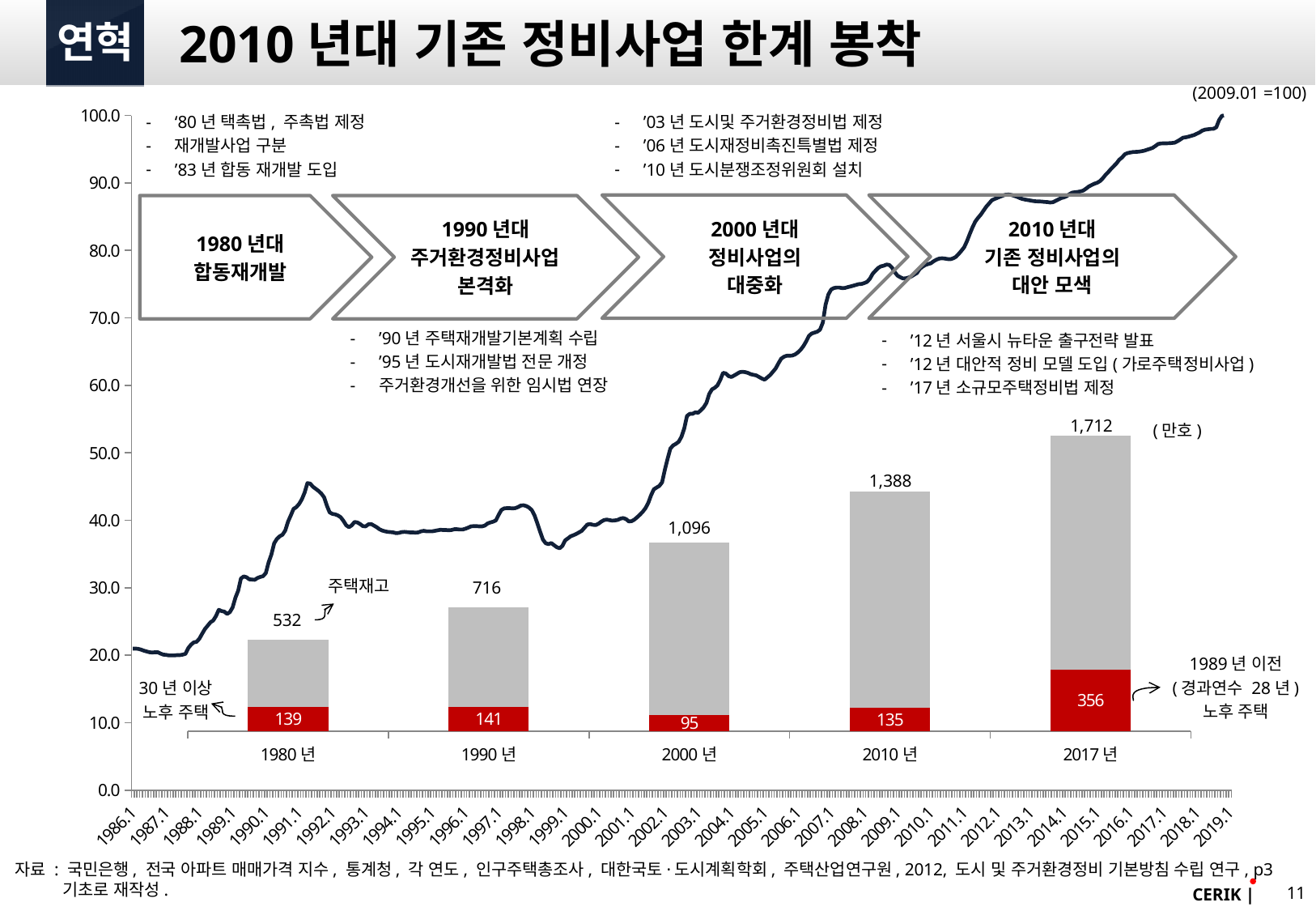
What base period is the line index set to 100, as noted at the top right of the chart? 2009.01 =100 What is the difference between the housing stock values for 2017 년 and 2010 년? 324 What is the housing stock (주택재고) value shown for 2017 년? 1,712 Does the line series generally rise or fall from 1986.1 to 2019.1? rise What is the value of the red segment (노후 주택) for 2000 년? 95 What is the value of the red segment (30 년 이상 노후 주택) for 1980 년? 139 Is the line value at 2019.1 greater or less than 90.0? greater What is the difference between the red segment values for 2017 년 and 2010 년? 221 Which is larger, the red segment value for 1990 년 or for 1980 년? 1990 년 Which year has the lowest red segment (노후 주택) value among the bars? 2000 년 Which year has the highest housing stock (주택재고) value among the bars? 2017 년 How many bars (years) are shown in the bar chart? 5